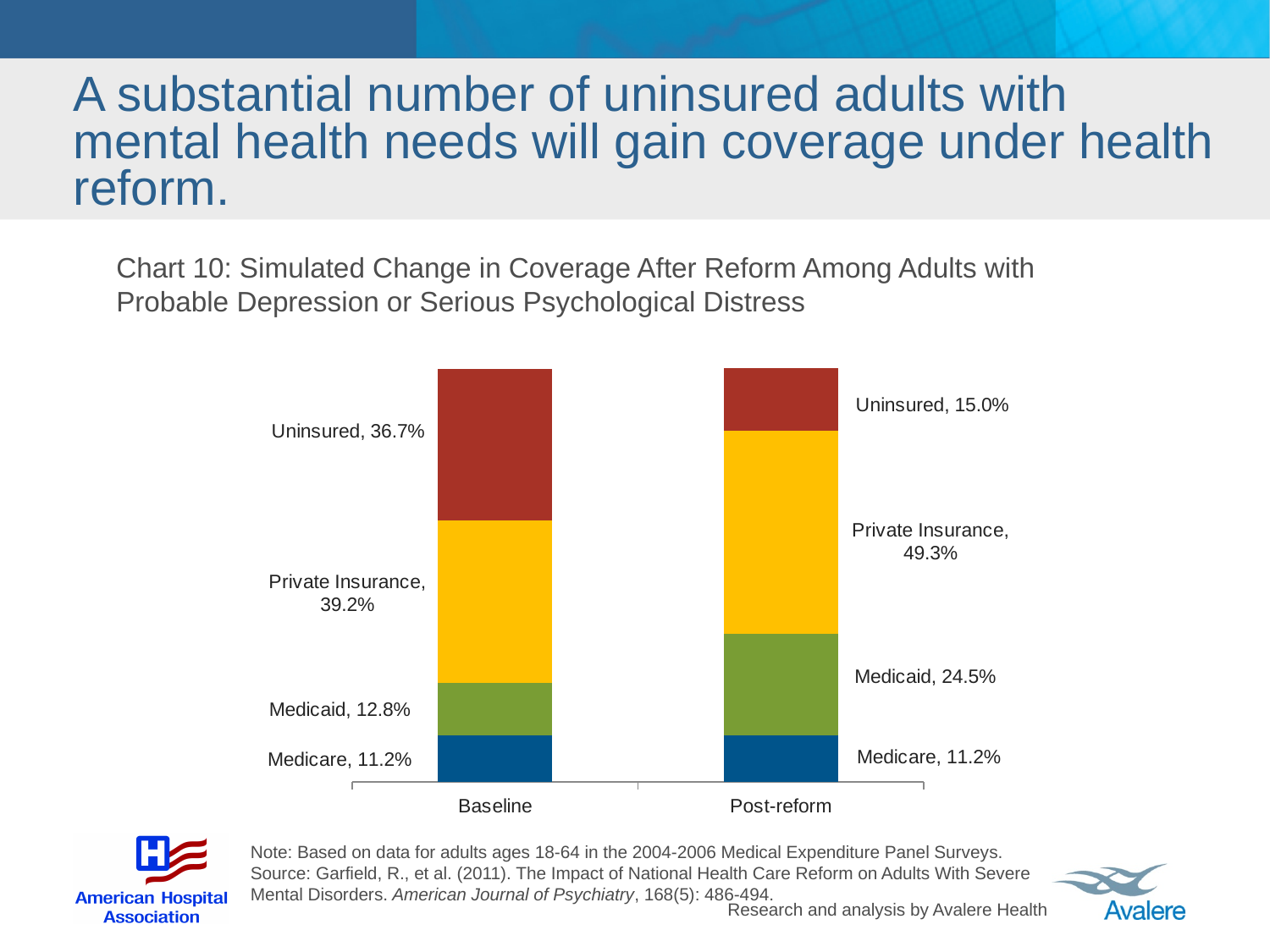
By how many percentage points does the Medicaid share rise from Baseline to Post-reform? 11.7 percentage points Is the Private Insurance share larger in the Baseline bar or the Post-reform bar? Post-reform Which segment is the largest in the Post-reform bar? Private Insurance What is the Uninsured share in the Baseline bar? 36.7% What kind of chart is this? Stacked bar chart Which segment is the smallest in the Baseline bar? Medicare What is the Medicare share in the Post-reform bar? 11.2% What is the Uninsured share in the Post-reform bar? 15.0% What is the Private Insurance share in the Post-reform bar? 49.3% By how many percentage points does the Uninsured share fall from Baseline to Post-reform? 21.7 percentage points What is the Medicaid share in the Baseline bar? 12.8% How many bars (categories) are shown on the x axis? 2